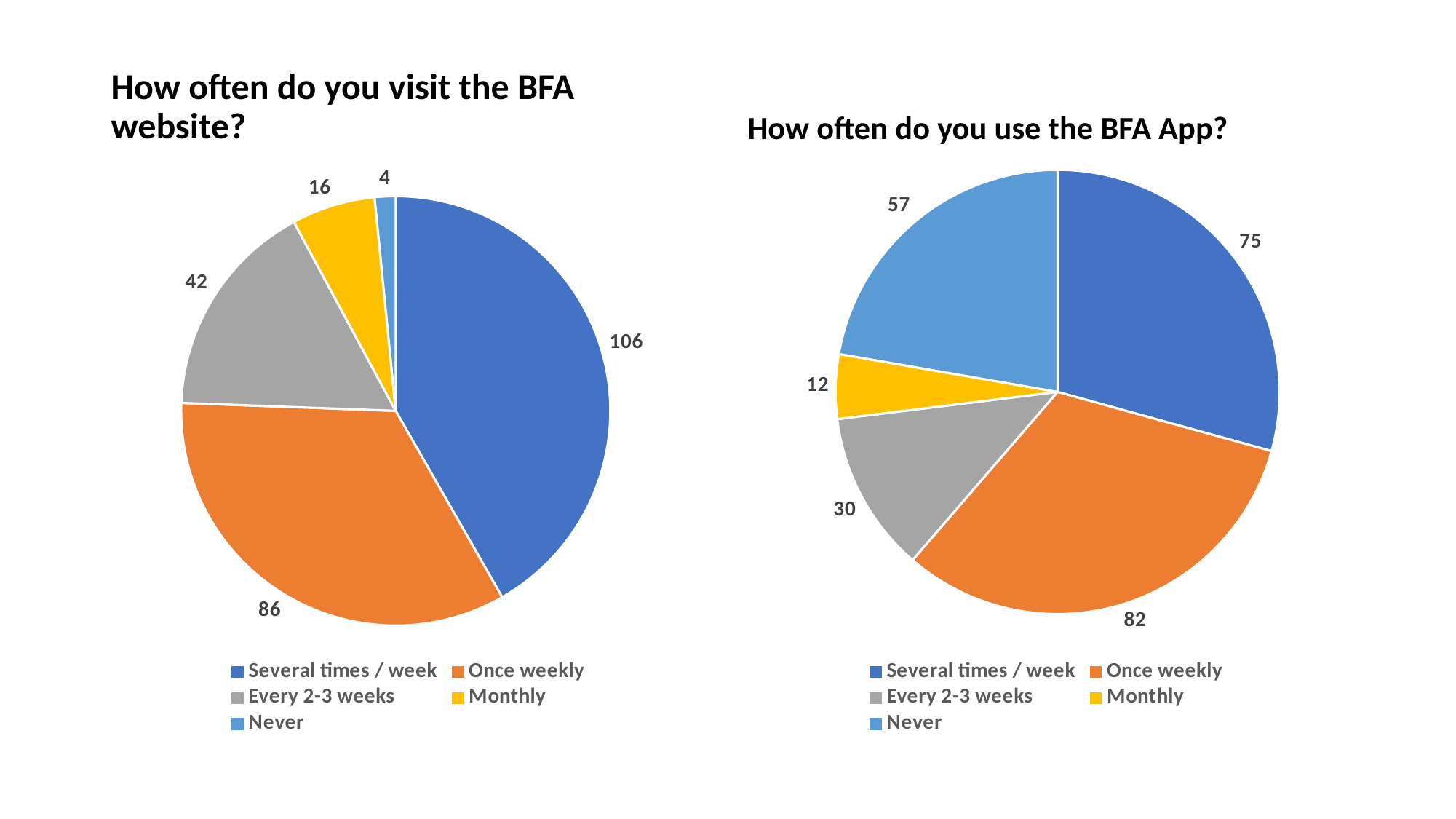
How many categories does the 'How often do you visit the BFA website?' chart show? 5 In the 'How often do you visit the BFA website?' chart, which is larger: 'Every 2-3 weeks' or 'Monthly'? Every 2-3 weeks In the 'How often do you use the BFA App?' chart, what is the difference between 'Never' and 'Monthly'? 45 In the 'How often do you use the BFA App?' chart, which is larger: 'Every 2-3 weeks' or 'Never'? Never What type of chart is used for 'How often do you use the BFA App?'? Pie chart In the 'How often do you visit the BFA website?' chart, what colour is the 'Monthly' slice? Yellow In the 'How often do you use the BFA App?' chart, which category has the largest slice? Once weekly In the 'How often do you visit the BFA website?' chart, what is the difference between 'Several times / week' and 'Once weekly'? 20 In the 'How often do you visit the BFA website?' chart, what is the value for 'Several times / week'? 106 In the 'How often do you use the BFA App?' chart, what is the total of all slices? 256 In the 'How often do you use the BFA App?' chart, what is the value for 'Never'? 57 In the 'How often do you visit the BFA website?' chart, which category has the smallest slice? Never